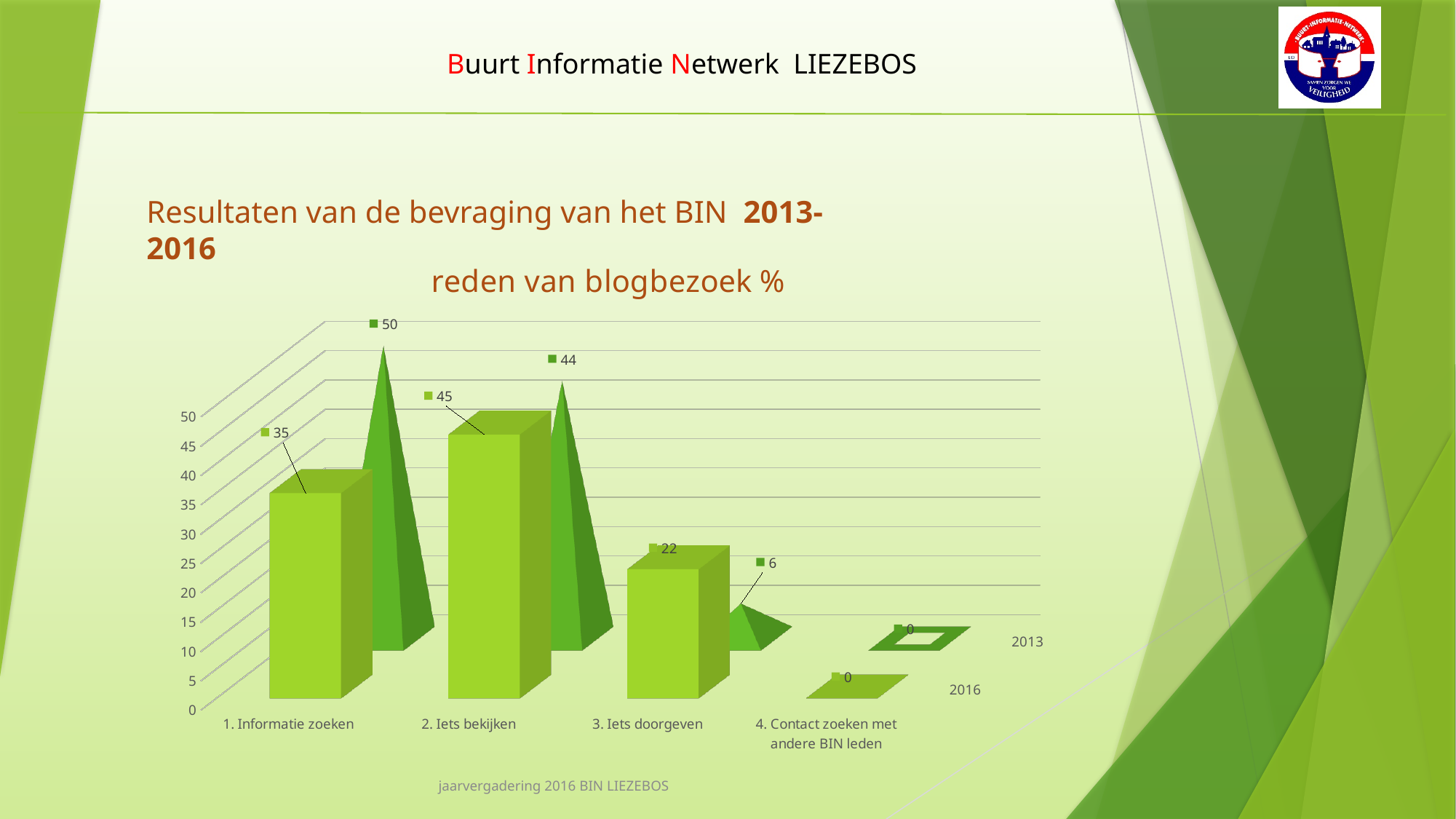
Which category has the highest value in the 2016 series? 2. Iets bekijken Which is larger for '2. Iets bekijken': the 2013 value or the 2016 value? 2016 Which category has the highest value in the 2013 series? 1. Informatie zoeken What is the value for '4. Contact zoeken met andere BIN leden' in the 2013 series? 0 What is the value for '1. Informatie zoeken' in the 2016 series? 35 What type of chart is shown on the slide? Bar chart What is the title of the chart? reden van blogbezoek % How many categories are shown on the x axis of the chart? 4 What is the difference between the 2013 and 2016 values for '1. Informatie zoeken'? 15 What is the value for '2. Iets bekijken' in the 2013 series? 44 What is the difference between the 2013 and 2016 values for '3. Iets doorgeven'? 16 What is the value for '3. Iets doorgeven' in the 2016 series? 22